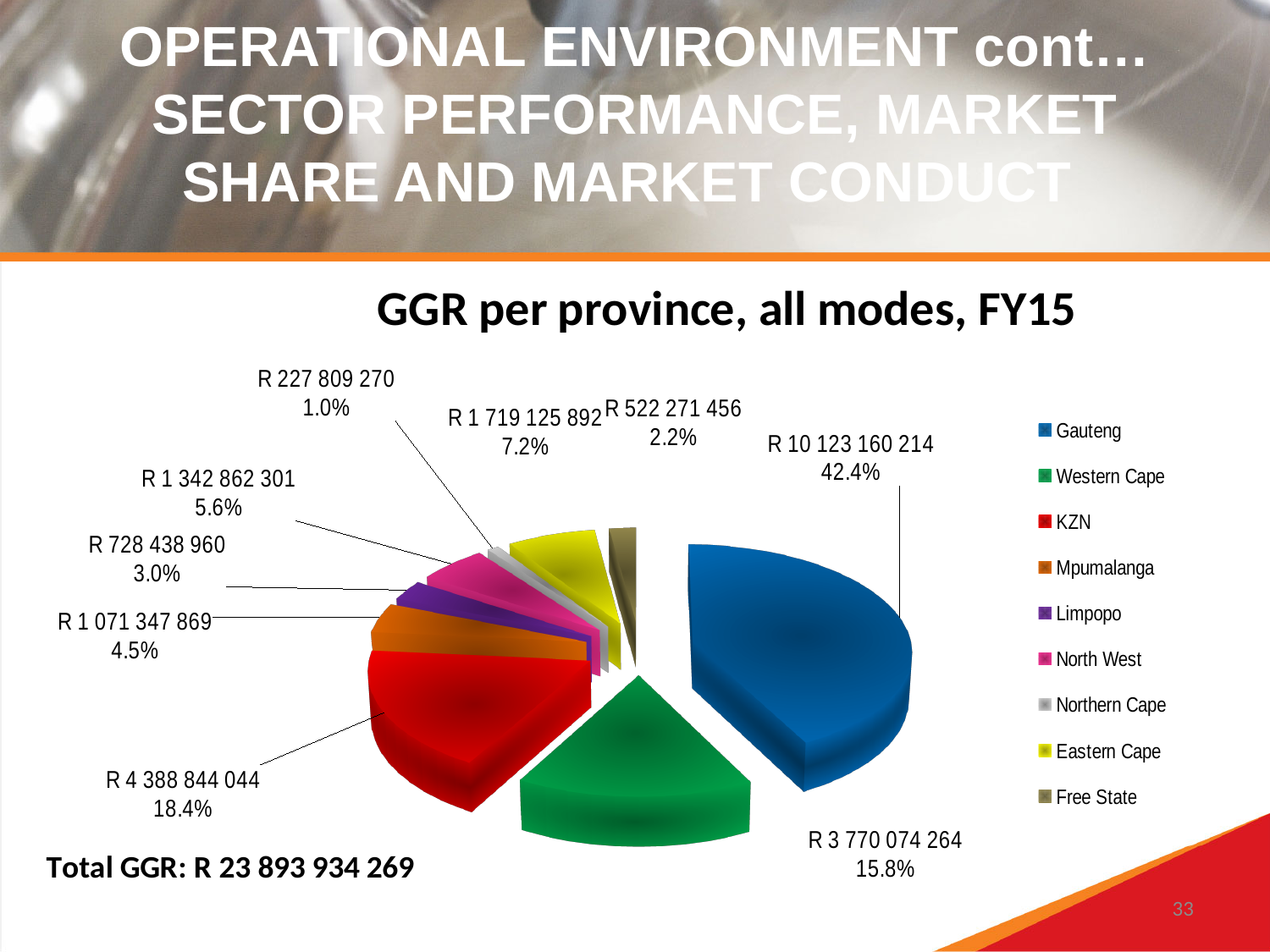
What percentage share of GGR does Western Cape hold? 15.8% What percentage share of GGR does Gauteng hold? 42.4% Which province has the largest share of GGR? Gauteng What is the GGR value shown for Gauteng? R 10 123 160 214 What is the GGR value shown for KZN? R 4 388 844 044 Which has a larger GGR share, KZN or Western Cape? KZN What kind of chart is shown on the slide? Pie chart Which province has the smallest share of GGR? Northern Cape What is the difference in percentage share between Eastern Cape (7.2%) and North West (5.6%)? 1.6% What is the total GGR stated on the slide? R 23 893 934 269 What is the title of the chart? GGR per province, all modes, FY15 How many provinces are listed in the chart legend? 9